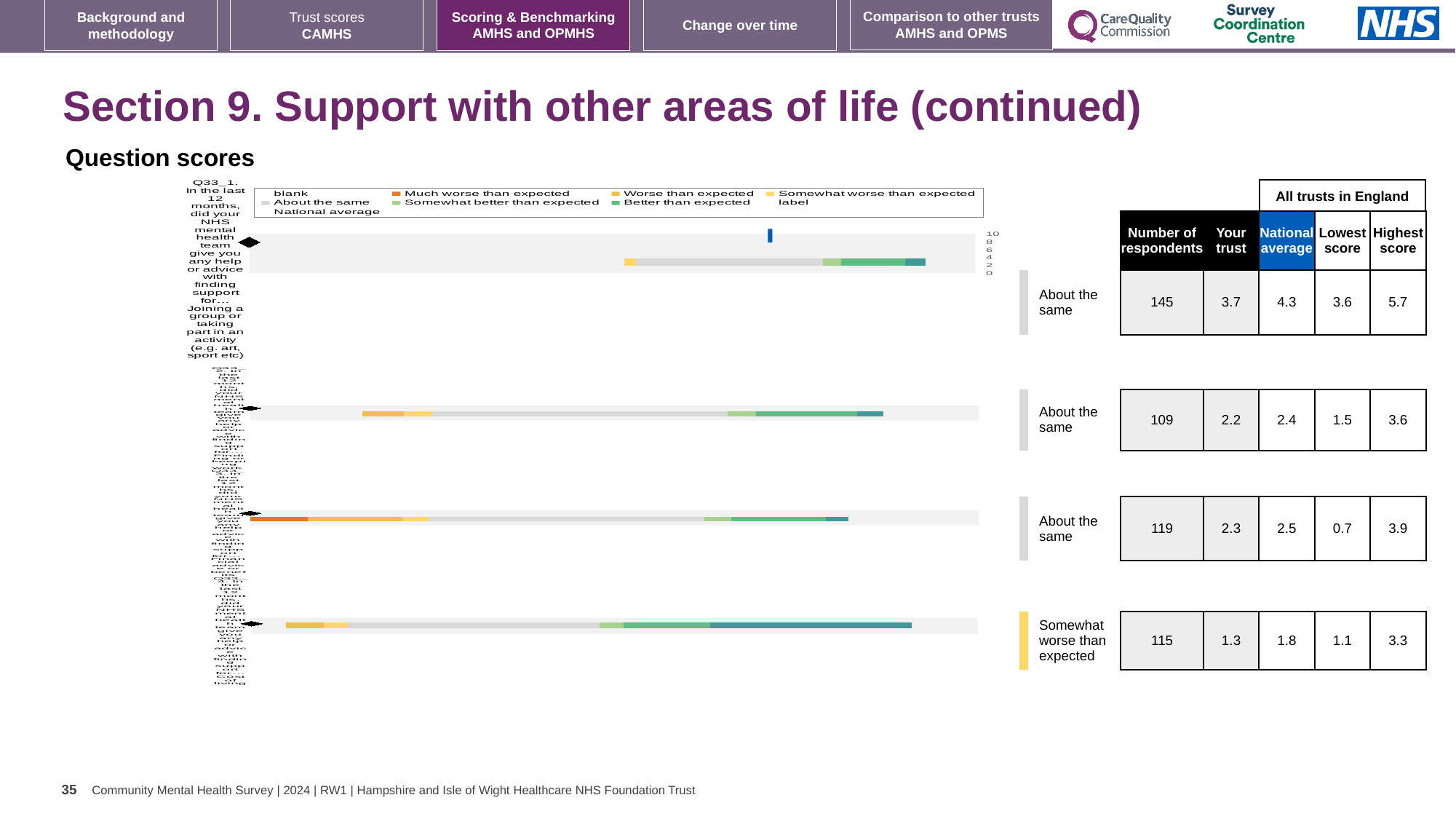
In the table beside the chart, what is the highest score for the first bar (Q33_1, joining a group or taking part in an activity)? 5.7 For the first bar (Q33_1), which is larger: the 'Your trust' score or the national average? National average In the table beside the chart, what is the 'Your trust' score for the first bar (Q33_1, joining a group or taking part in an activity)? 3.7 Which legend entry is shown in orange? Much worse than expected What is the first entry in the chart's legend? blank Which bar in the chart is labelled 'Somewhat worse than expected'? The fourth (bottom) bar For the first bar (Q33_1), what is the difference between the national average (4.3) and the 'Your trust' score (3.7)? 0.6 In the table beside the chart, what is the national average for the first bar (Q33_1, joining a group or taking part in an activity)? 4.3 How many entries does the chart's legend list? 9 What kind of chart is shown under 'Question scores'? bar chart How many bars (questions) are plotted in the chart? 4 In the table beside the chart, what is the number of respondents for the first bar (Q33_1, joining a group or taking part in an activity)? 145